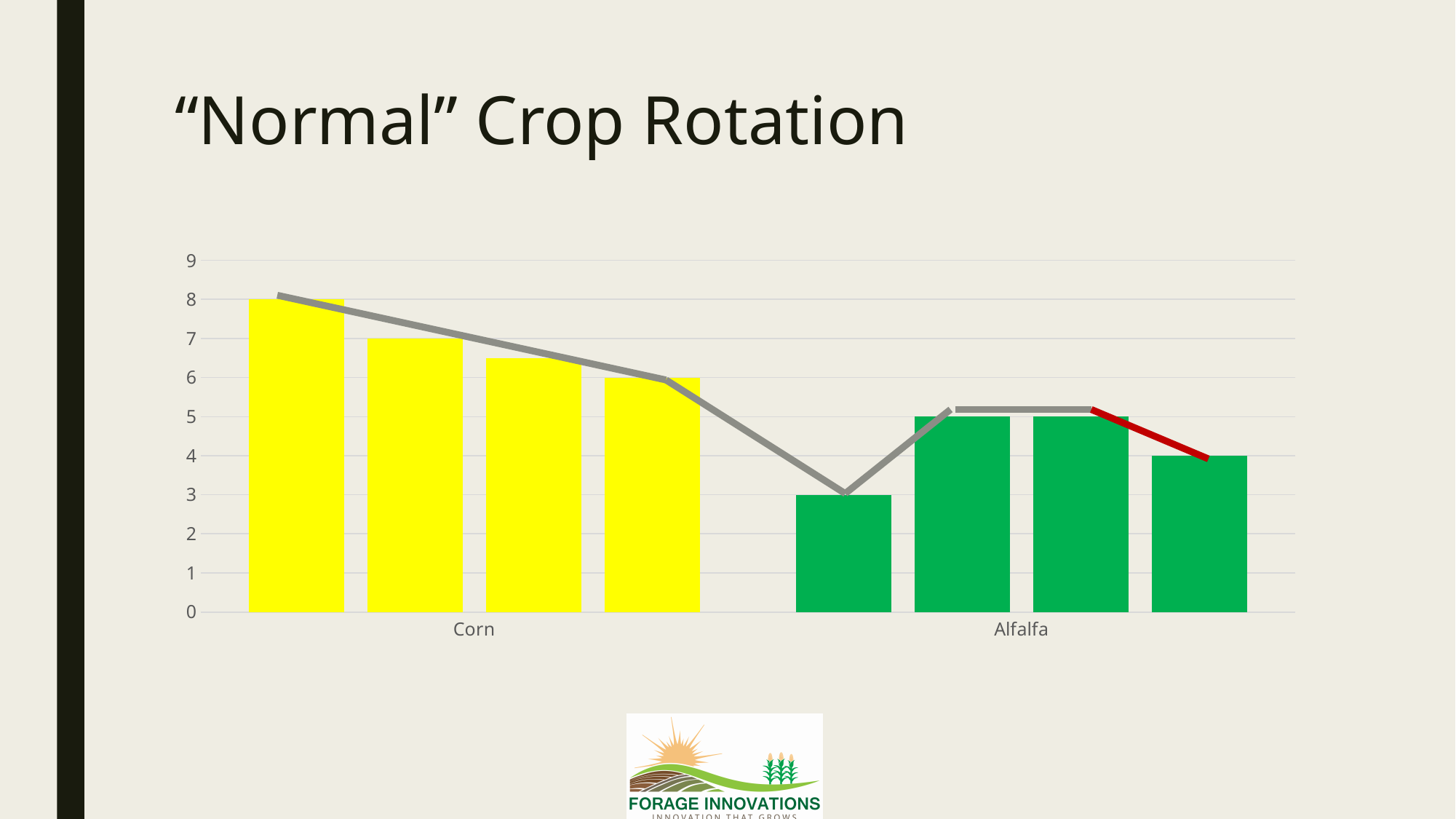
What is the value of the first (leftmost) bar in the Corn group? 8 Which bar is the shortest in the chart? the first bar in the Alfalfa group What colour are the bars in the Alfalfa group? green How many bars are plotted in the chart in total? 8 Do the bars in the Corn group rise or fall from left to right? fall Which bar is the tallest in the chart? the first bar in the Corn group What is the value of the first (leftmost) bar in the Alfalfa group? 3 What kind of chart is shown on the slide? bar chart What is the value of the last (rightmost) bar in the Alfalfa group? 4 How many category groups are labelled on the x axis? 2 Is the value of the third bar in the Corn group greater or less than 6? greater What is the title of the slide? "Normal" Crop Rotation